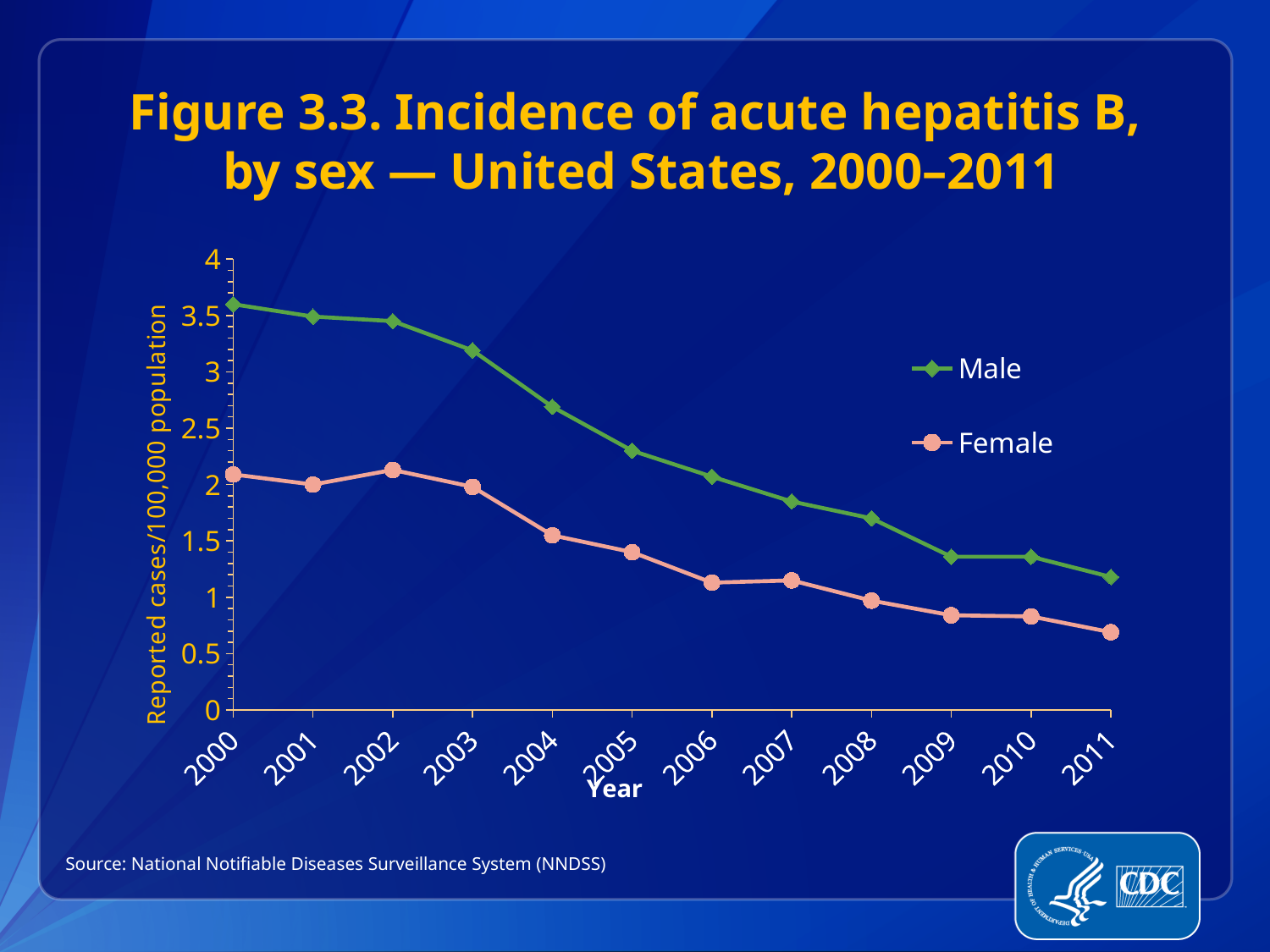
Is the Male value for 2007 greater or less than 2? less What is the label of the y axis? Reported cases/100,000 population Is the Female value for 2011 greater or less than 1? less How many years are plotted along the x axis? 12 In 2005, which series has the larger value, Male or Female? Male In which year is the Male value lowest? 2011 In which year is the Male value highest? 2000 Do the Male values rise or fall from 2000 to 2011? fall Is the Male value for 2004 greater or less than 2.5? greater How many series does the legend list? 2 What kind of chart is shown on the slide? line chart In which year is the Female value lowest? 2011